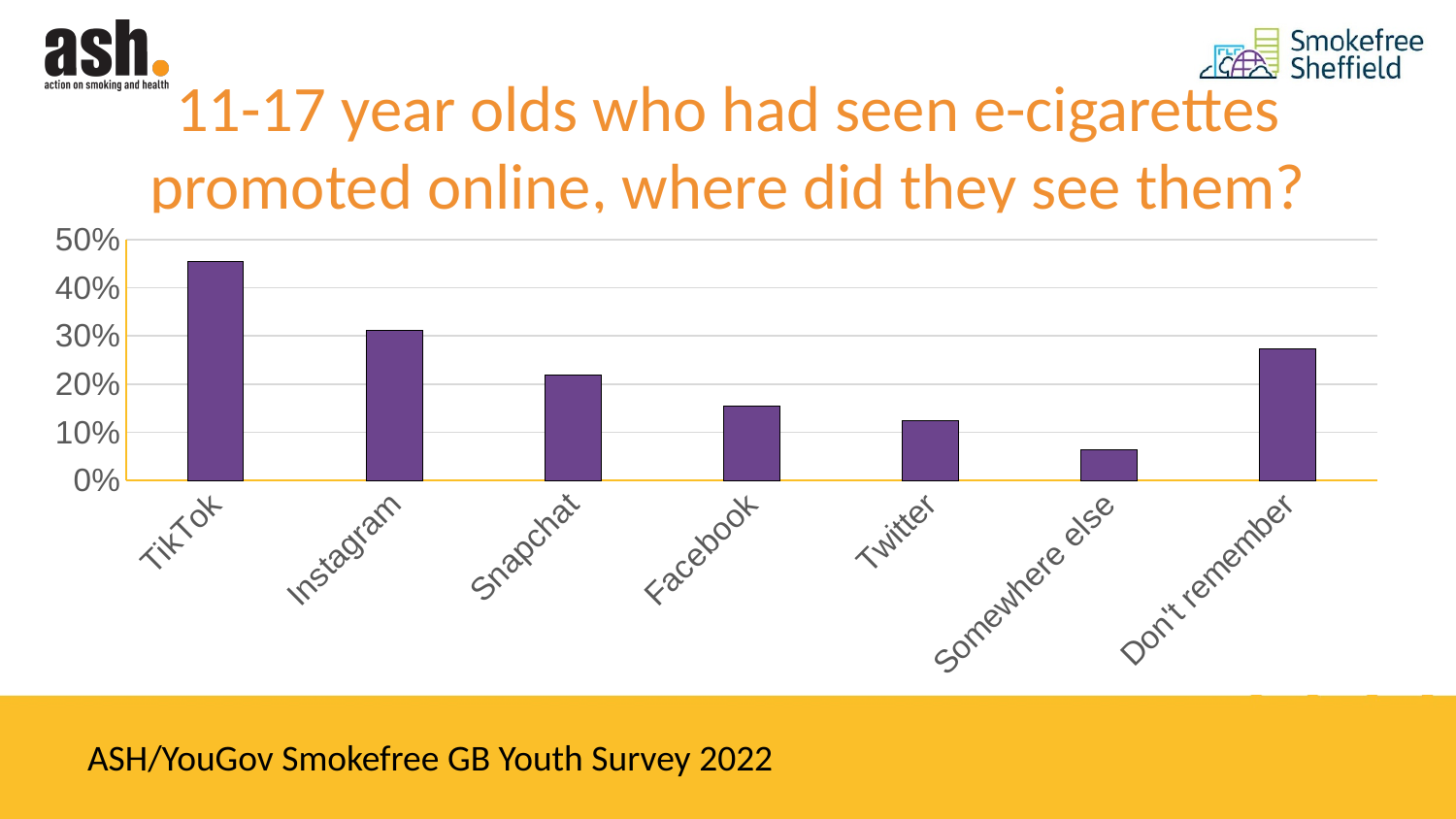
Which category has the lowest value? Somewhere else What kind of chart is shown on the slide? bar chart Is the value for Instagram greater or less than 40%? less Which category has the highest value? TikTok Is the value for Facebook greater or less than 20%? less Is the value for TikTok greater or less than 40%? greater What is the title of the chart? 11-17 year olds who had seen e-cigarettes promoted online, where did they see them? Which is larger, the value for Instagram or the value for Don't remember? Instagram How many categories are shown on the x axis of the chart? 7 Which is larger, the value for Snapchat or the value for Twitter? Snapchat